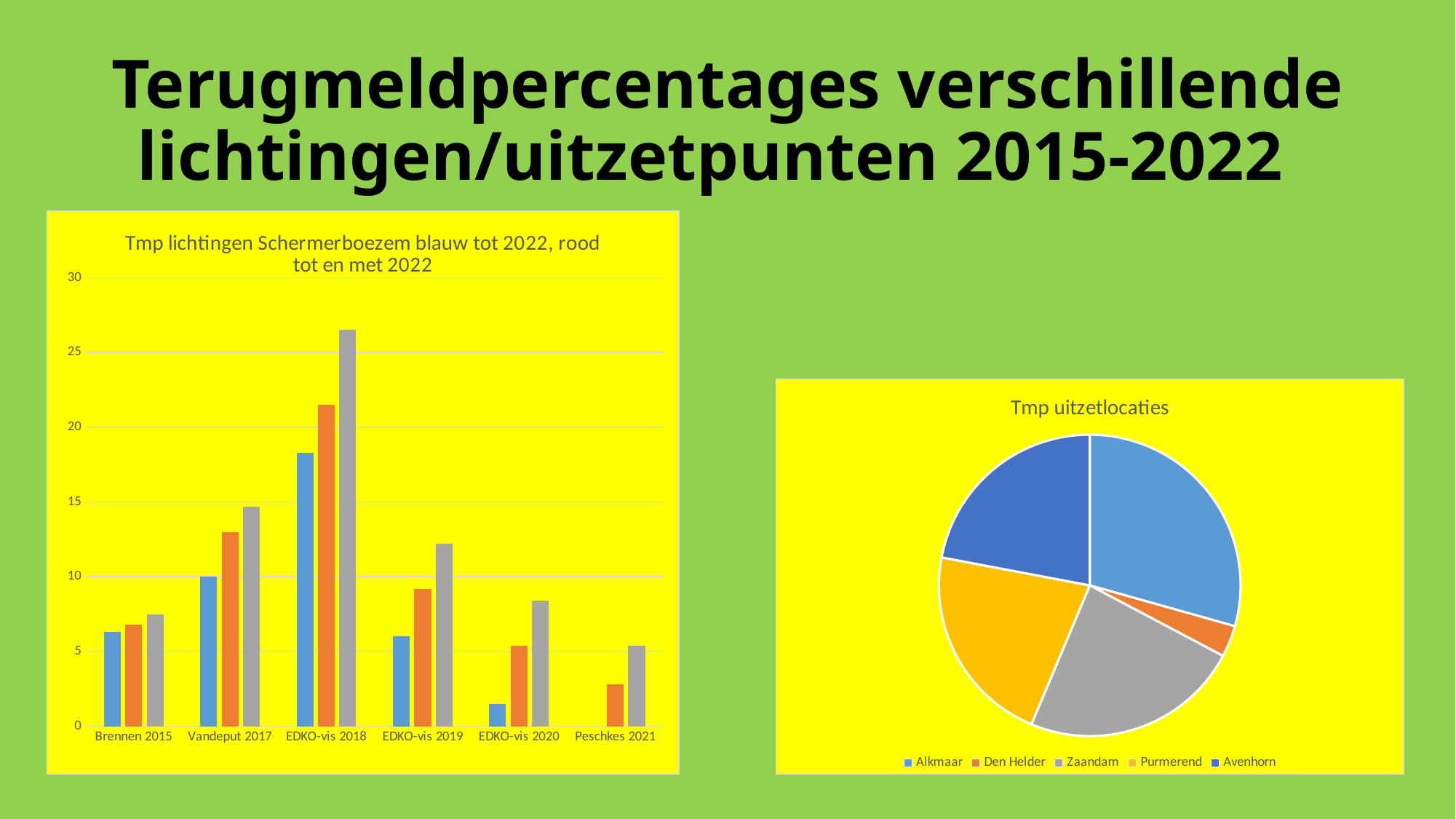
In the bar chart on the left, is the blue bar for Vandeput 2017 greater or less than 15? less In the bar chart on the left, which is larger: the orange bar for EDKO-vis 2018 or the orange bar for EDKO-vis 2019? EDKO-vis 2018 In the bar chart on the left, how many bars are plotted for each category? 3 In the pie chart 'Tmp uitzetlocaties', which location has the smallest slice? Den Helder In the bar chart on the left, which category contains the tallest bar? EDKO-vis 2018 In the pie chart 'Tmp uitzetlocaties', how many entries does the legend list? 5 What kind of chart is the chart on the right, titled 'Tmp uitzetlocaties'? pie chart In the bar chart on the left, do the grey bars rise or fall from EDKO-vis 2018 to Peschkes 2021? fall What kind of chart is the chart on the left, titled 'Tmp lichtingen Schermerboezem blauw tot 2022, rood tot en met 2022'? bar chart In the bar chart on the left, is the grey bar for EDKO-vis 2018 greater or less than 25? greater What is the title of the pie chart on the right? Tmp uitzetlocaties In the bar chart on the left, how many categories are shown on the x axis? 6